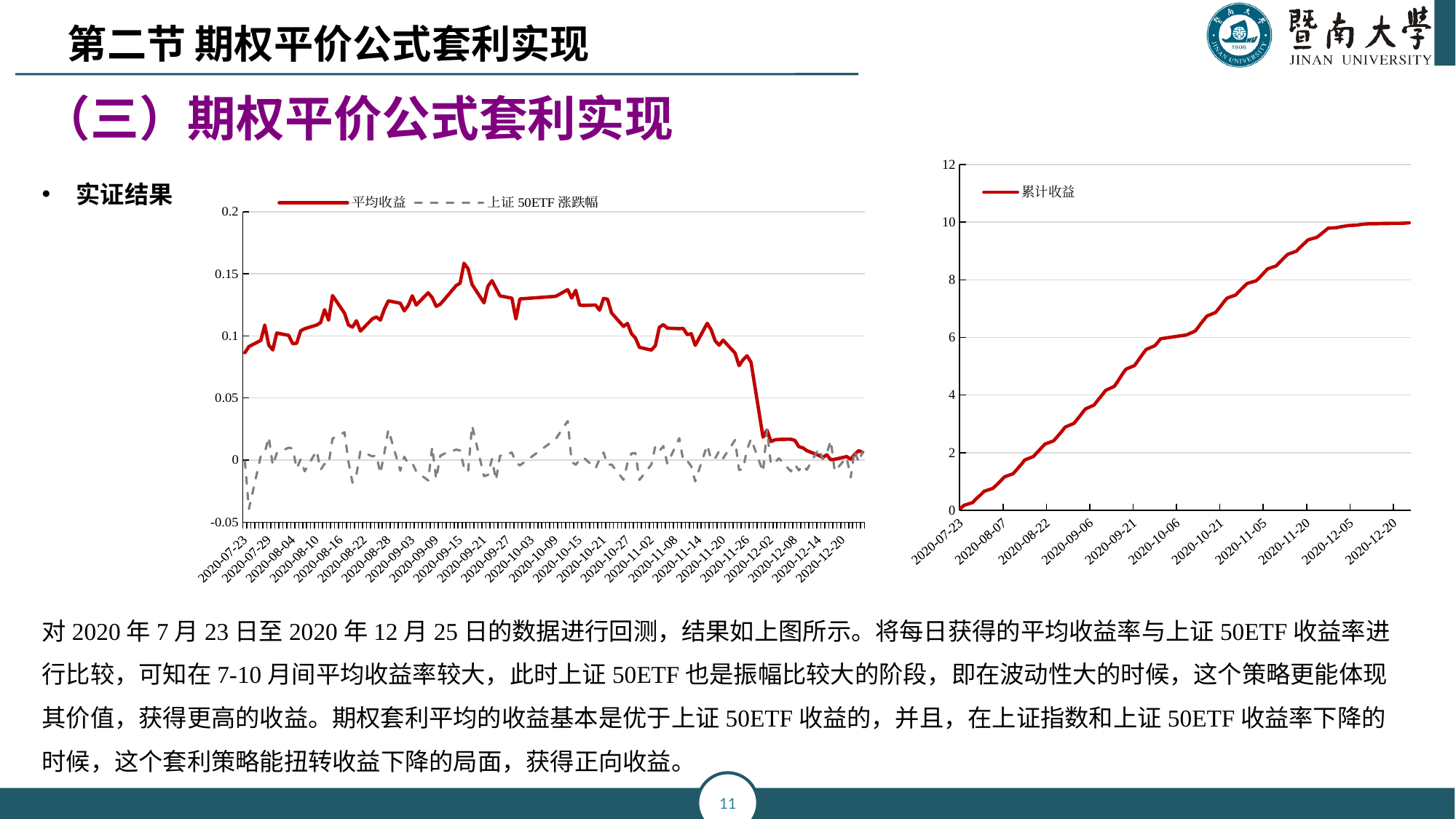
What is the name of the series plotted in the right chart? 累计收益 In the right chart, is the value of 累计收益 at 2020-08-22 greater or less than 4? less In the left chart, which series is higher around 2020-09-15, 平均收益 or 上证 50ETF 涨跌幅? 平均收益 In the left chart, which series is drawn with a dashed gray line? 上证 50ETF 涨跌幅 How many series does the legend of the right chart list? 1 In the left chart, is the value of 平均收益 at 2020-12-20 greater or less than 0.05? less How many series does the legend of the left chart list? 2 What kind of chart is the right chart (累计收益) on the slide? line chart In the right chart, does the 累计收益 line rise or fall from 2020-07-23 to 2020-12-20? rise In the right chart, is the value of 累计收益 at 2020-12-20 greater or less than 8? greater What kind of chart is the left chart on the slide? line chart